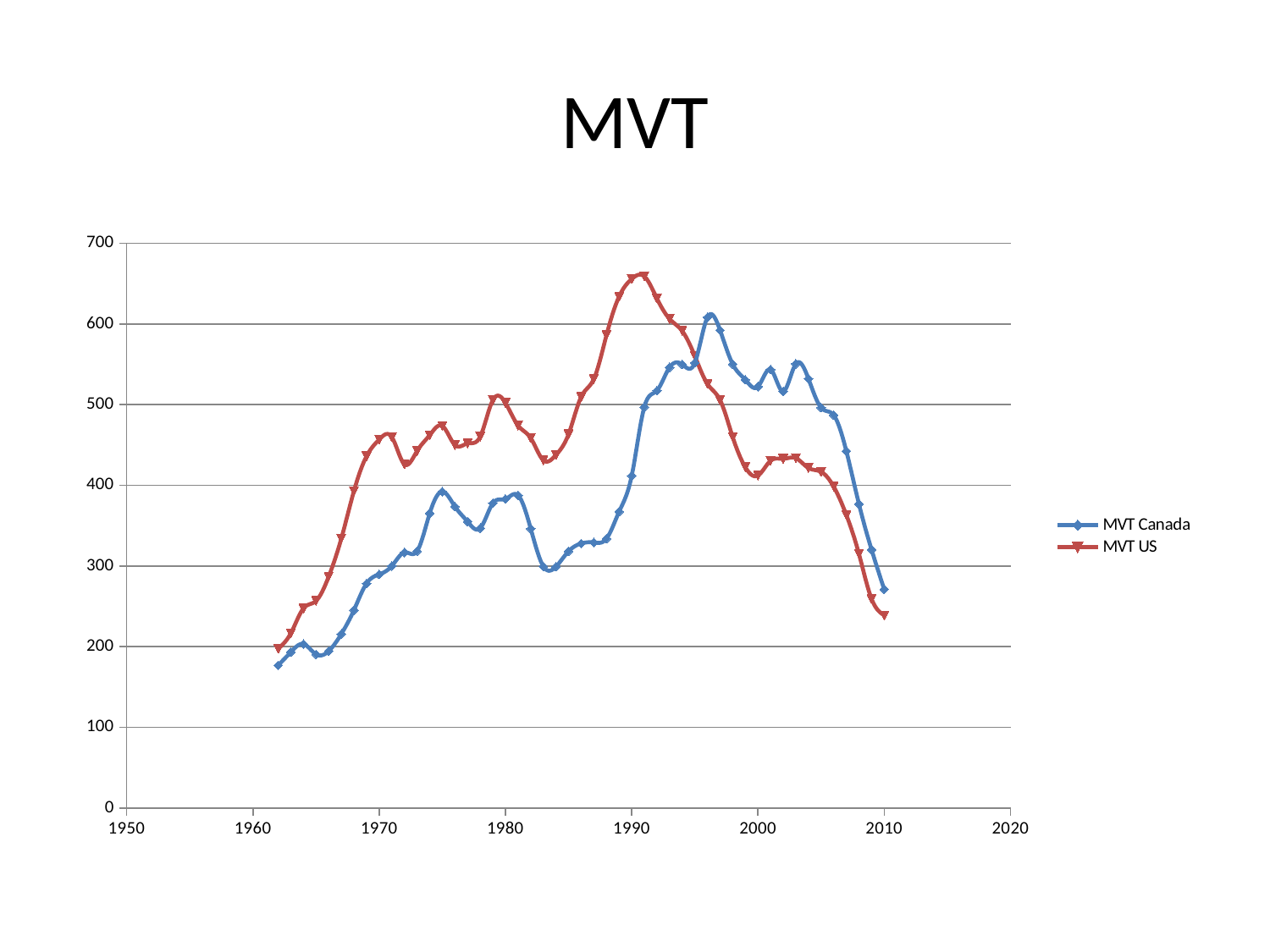
What is the title of the chart? MVT Which series reaches the highest value anywhere on the chart? MVT US In 1990, which series has the higher value, MVT Canada or MVT US? MVT US Does the MVT US series rise or fall between 2005 and 2010? fall Which series is drawn in red? MVT US Is the value for MVT Canada in 1962 greater or less than 200? less Is the value for MVT US in 1970 greater or less than 400? greater Is the value for MVT US in 2010 greater or less than 300? less How many series does the legend list? 2 In 2000, which series has the higher value, MVT Canada or MVT US? MVT Canada What kind of chart is shown on the slide? line chart